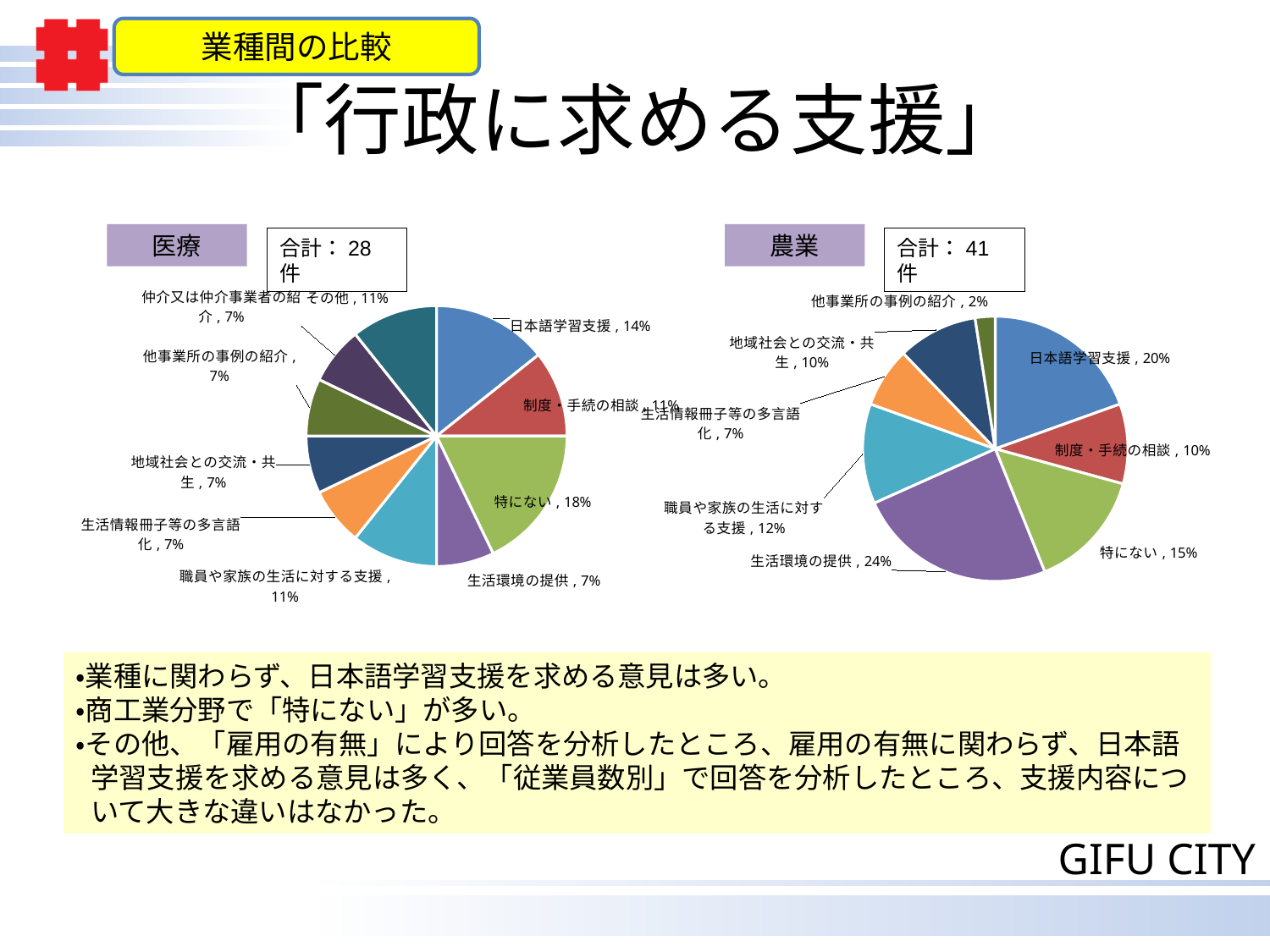
How many slices does the 農業 pie chart on the right have? 8 What type of chart is used for the 医療 data on the left? Pie chart What is the difference in percentage points between 日本語学習支援 in the 農業 chart and 日本語学習支援 in the 医療 chart? 6 percentage points In the 医療 pie chart on the left, which category has the largest share? 特にない In the 医療 pie chart on the left, what percentage is shown for 日本語学習支援? 14% What is the total number of responses (合計) shown for the 農業 chart? 41件 In the 農業 pie chart on the right, which category has the largest share? 生活環境の提供 In the 農業 pie chart on the right, what percentage is shown for 生活環境の提供? 24% In the 農業 pie chart on the right, which is larger: 特にない or 職員や家族の生活に対する支援? 特にない How many slices does the 医療 pie chart on the left have? 10 In the 農業 pie chart on the right, which category has the smallest share? 他事業所の事例の紹介 In the 医療 pie chart on the left, what percentage is shown for 制度・手続の相談? 11%